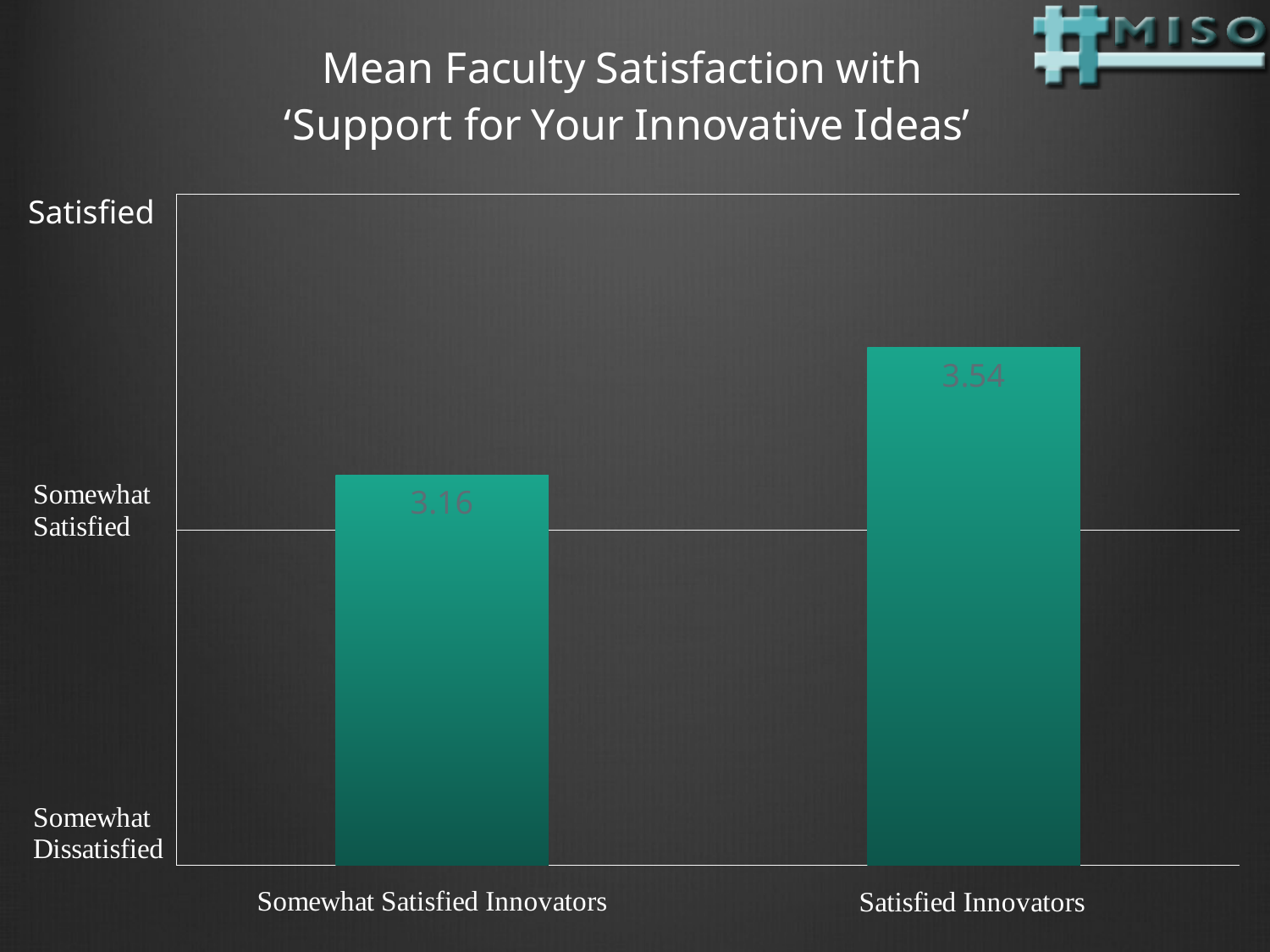
What is the mean satisfaction value for Somewhat Satisfied Innovators? 3.16 Do the values rise or fall from left to right along the x axis? rise What is the mean satisfaction value for Satisfied Innovators? 3.54 Which category has the lower mean satisfaction value? Somewhat Satisfied Innovators How many categories are shown on the x axis? 2 Is the value for Satisfied Innovators larger or smaller than the value for Somewhat Satisfied Innovators? larger What kind of chart is shown on the slide? bar chart Which category has the higher mean satisfaction value? Satisfied Innovators What is the label of the topmost tick on the y axis? Satisfied What is the title of the chart? Mean Faculty Satisfaction with 'Support for Your Innovative Ideas' What is the difference between the values for Satisfied Innovators and Somewhat Satisfied Innovators? 0.38